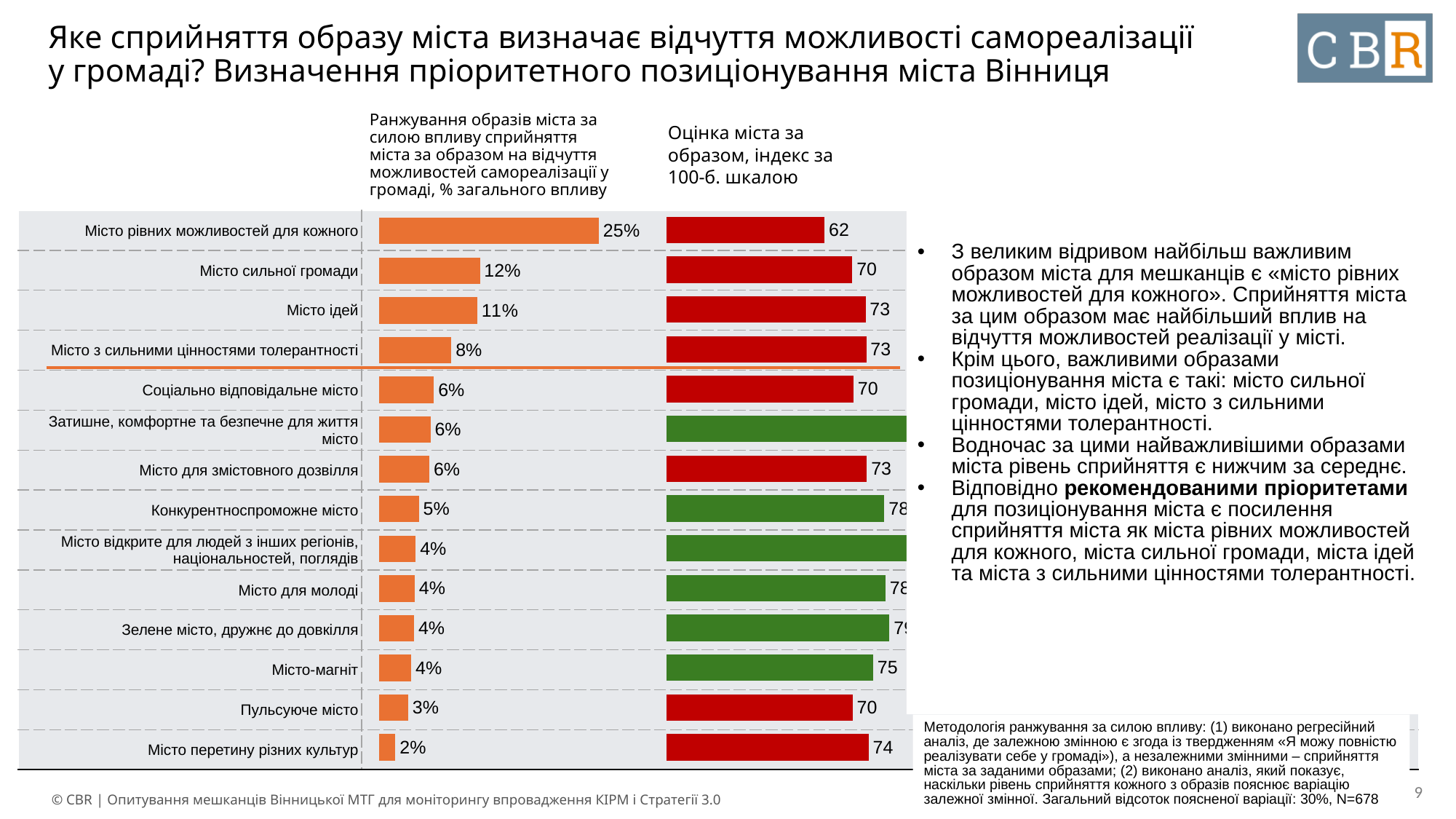
In the right chart (Оцінка міста за образом, індекс за 100-б. шкалою), what is the value for «Місто-магніт»? 75 In the left chart (Ранжування образів міста за силою впливу), which category has the lowest value? Місто перетину різних культур In the right chart (Оцінка міста за образом, індекс за 100-б. шкалою), what is the difference between «Місто перетину різних культур» and «Пульсуюче місто»? 4 How many categories are shown in the left chart (Ранжування образів міста за силою впливу)? 14 What type of chart is used on the left (Ранжування образів міста за силою впливу)? Bar chart In the left chart (Ранжування образів міста за силою впливу), which category has the highest value? Місто рівних можливостей для кожного In the left chart (Ранжування образів міста за силою впливу), what is the value for «Місто рівних можливостей для кожного»? 25% In the left chart (Ранжування образів міста за силою впливу), what is the value for «Місто ідей»? 11% In the left chart (Ранжування образів міста за силою впливу), what is the difference between «Місто рівних можливостей для кожного» and «Місто сильної громади»? 13% In the right chart (Оцінка міста за образом, індекс за 100-б. шкалою), what is the value for «Місто рівних можливостей для кожного»? 62 In the right chart (Оцінка міста за образом, індекс за 100-б. шкалою), which is larger: the value for «Місто ідей» or the value for «Місто рівних можливостей для кожного»? Місто ідей In the right chart (Оцінка міста за образом, індекс за 100-б. шкалою), which category has the lowest value? Місто рівних можливостей для кожного